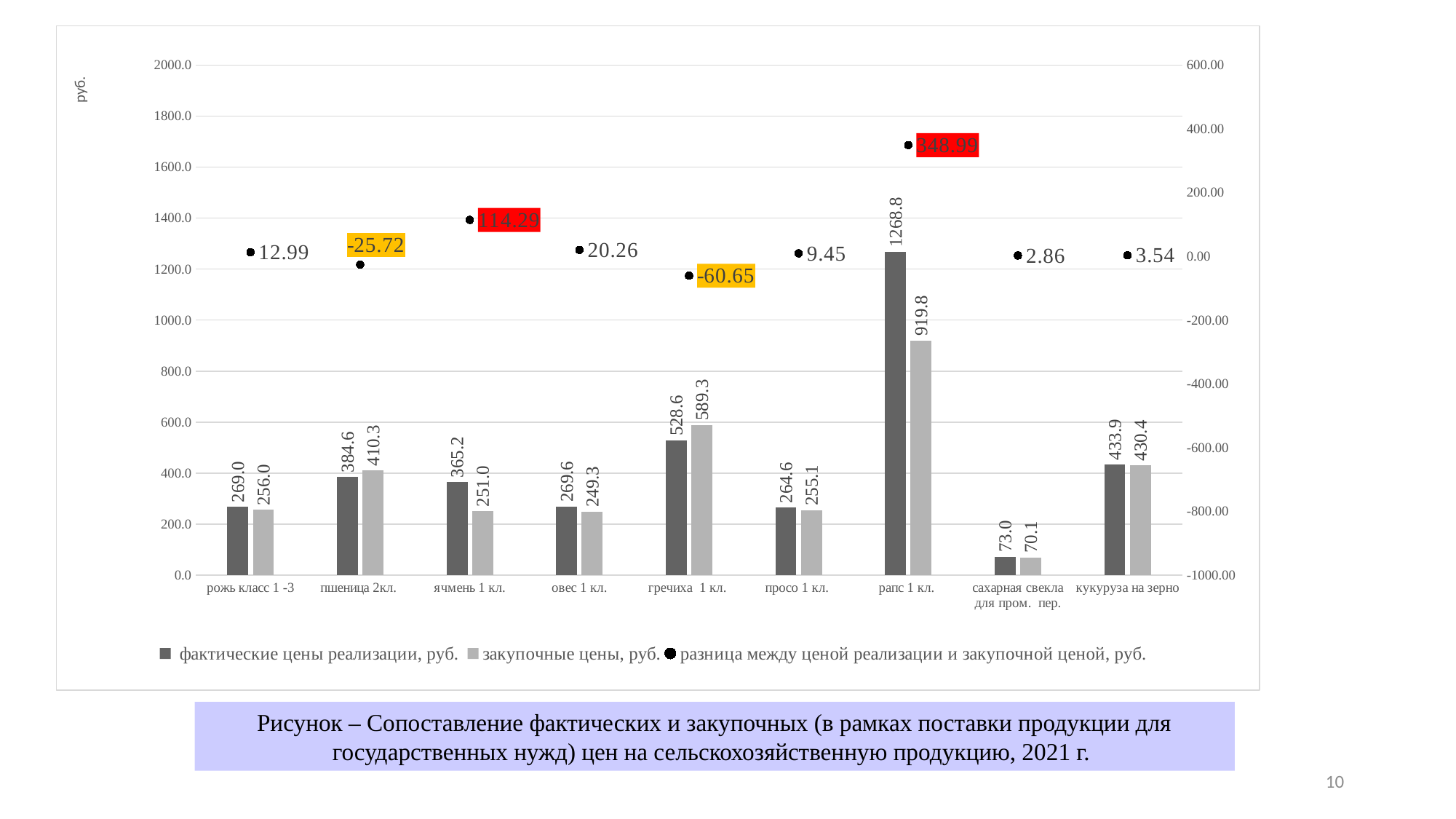
How many series does the legend list? 3 Which is larger for пшеница 2кл.: the actual selling price or the purchase price? закупочные цены (410.3) Which category has the highest actual selling price? рапс 1 кл. What is the unit label shown on the left vertical axis? руб. What is the actual selling price (фактические цены реализации) for рапс 1 кл.? 1268.8 What is the difference between selling and purchase price (разница) shown for ячмень 1 кл.? 114.29 What is the difference between the actual selling price and the purchase price for рапс 1 кл., based on the bar labels? 349.0 What type of chart is used for the price series (фактические цены реализации and закупочные цены)? bar chart How many product categories are shown on the x axis? 9 Which category has the lowest value for the difference series (разница между ценой реализации и закупочной ценой)? гречиха 1 кл. What is the purchase price (закупочные цены) for гречиха 1 кл.? 589.3 Which category has the lowest purchase price? сахарная свекла для пром. пер.